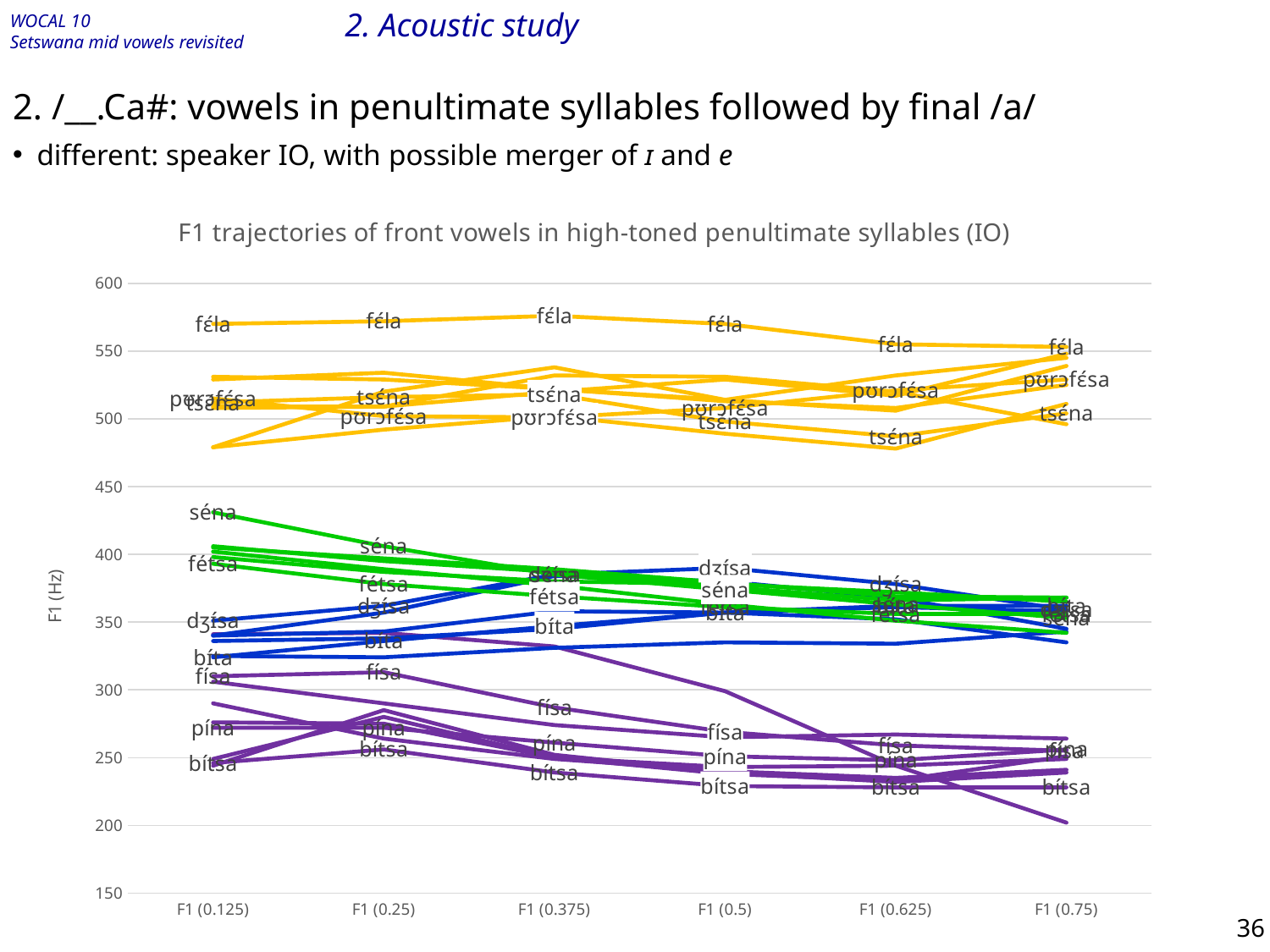
What is the label of the y axis? F1 (Hz) Does the F1 value for féla rise or fall from F1 (0.125) to F1 (0.75)? fall What kind of chart is shown on the slide? line chart Is the value for pína at F1 (0.125) greater or less than 300? less How many time points are shown along the x axis? 6 What is the title of the chart? F1 trajectories of front vowels in high-toned penultimate syllables (IO) At F1 (0.125), which has the higher F1 value, séna or bítsa? séna Is the value for féla at F1 (0.125) greater or less than 550? greater Is the value for tséna at F1 (0.625) greater or less than 500? less At F1 (0.625), which has the higher F1 value, féla or tséna? féla